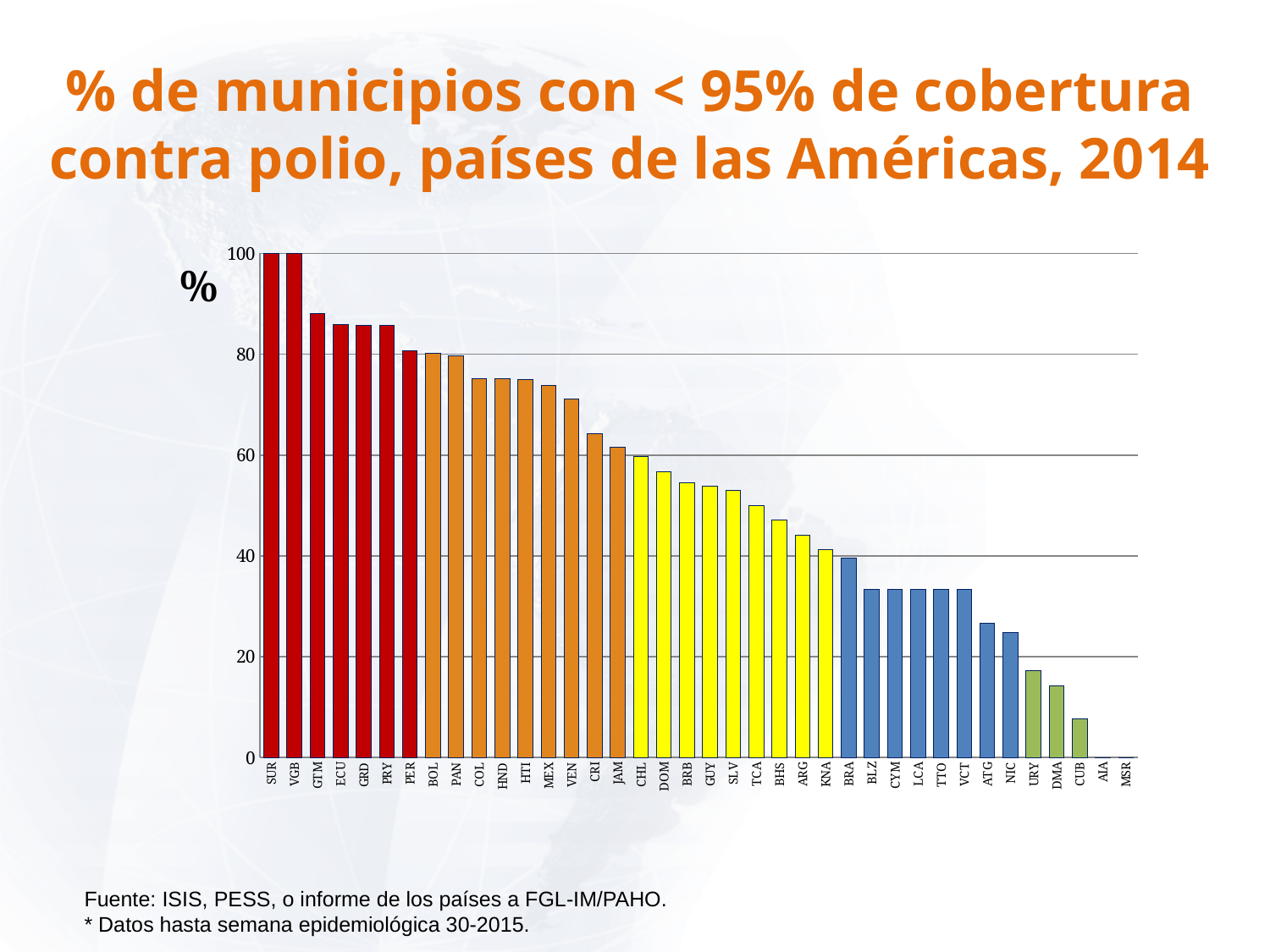
Do the values rise or fall from left to right along the x axis? fall Is the value for BLZ greater or less than 40? less Is the value for COL greater or less than 80? less What is the value for SUR? 100 What label is shown on the vertical axis of the chart? % Is the value for URY greater or less than 20? less Which is larger, the value for HTI or the value for KNA? HTI Which is larger, the value for GTM or the value for PER? GTM What is the value for VGB? 100 What kind of chart is shown on the slide? bar chart